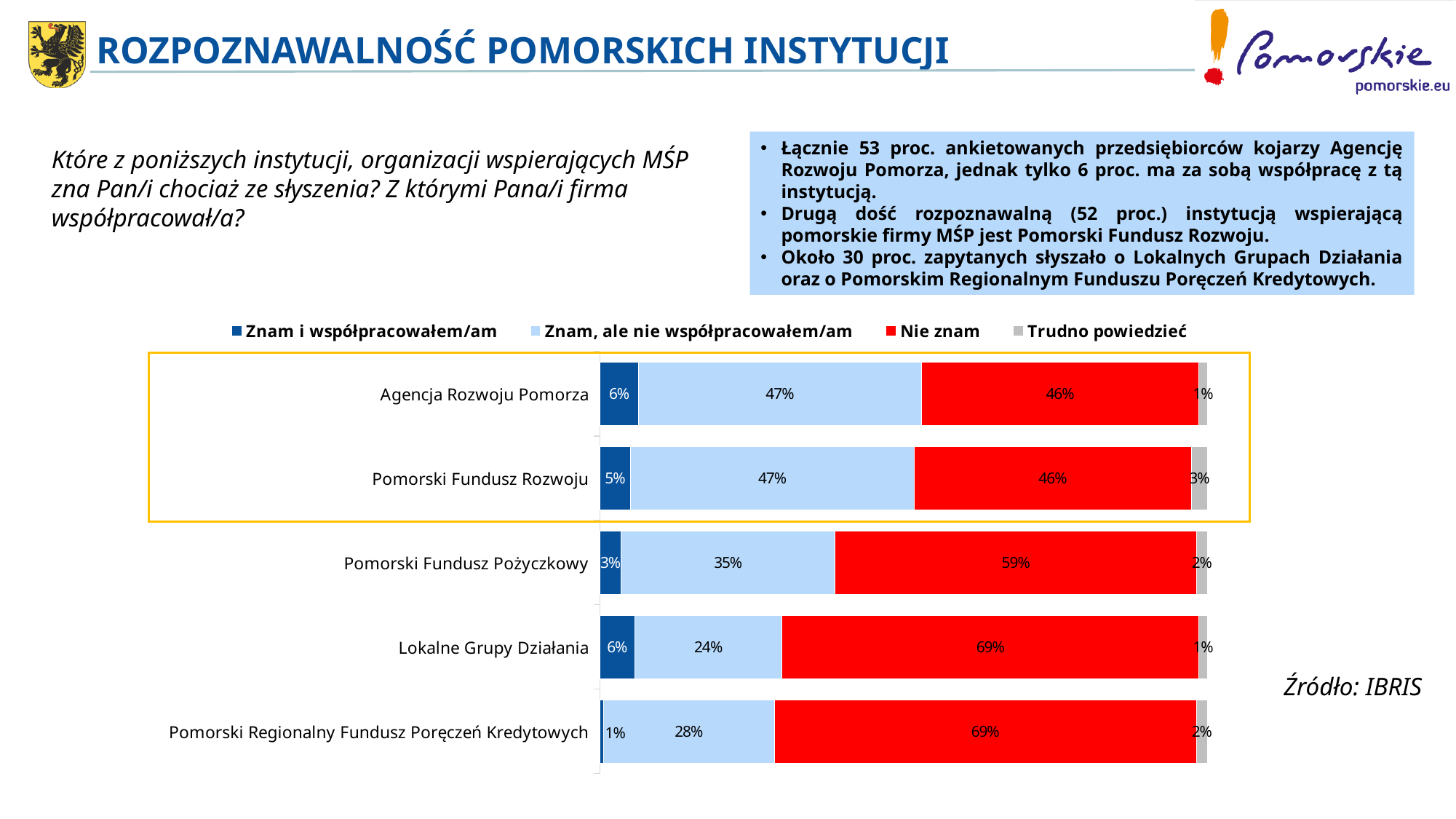
How many series does the legend list? 4 What percentage of respondents answered "Nie znam" for Pomorski Fundusz Pożyczkowy? 59% Which institution has the lowest "Znam i współpracowałem/am" share? Pomorski Regionalny Fundusz Poręczeń Kredytowych What is the difference between the "Nie znam" values for Lokalne Grupy Działania and Agencja Rozwoju Pomorza? 23 percentage points What is the "Znam i współpracowałem/am" value for Pomorski Regionalny Fundusz Poręczeń Kredytowych? 1% Which is larger: the "Znam, ale nie współpracowałem/am" value for Pomorski Fundusz Pożyczkowy or for Pomorski Regionalny Fundusz Poręczeń Kredytowych? Pomorski Fundusz Pożyczkowy How many institutions are shown in the chart? 5 What is the combined share of "Znam i współpracowałem/am" and "Znam, ale nie współpracowałem/am" for Agencja Rozwoju Pomorza? 53% What type of chart is shown on the slide? Stacked bar chart What is the "Trudno powiedzieć" value for Pomorski Fundusz Rozwoju? 3% Which institution has the highest "Znam, ale nie współpracowałem/am" share? Agencja Rozwoju Pomorza and Pomorski Fundusz Rozwoju (47%) What is the "Znam, ale nie współpracowałem/am" value for Lokalne Grupy Działania? 24%